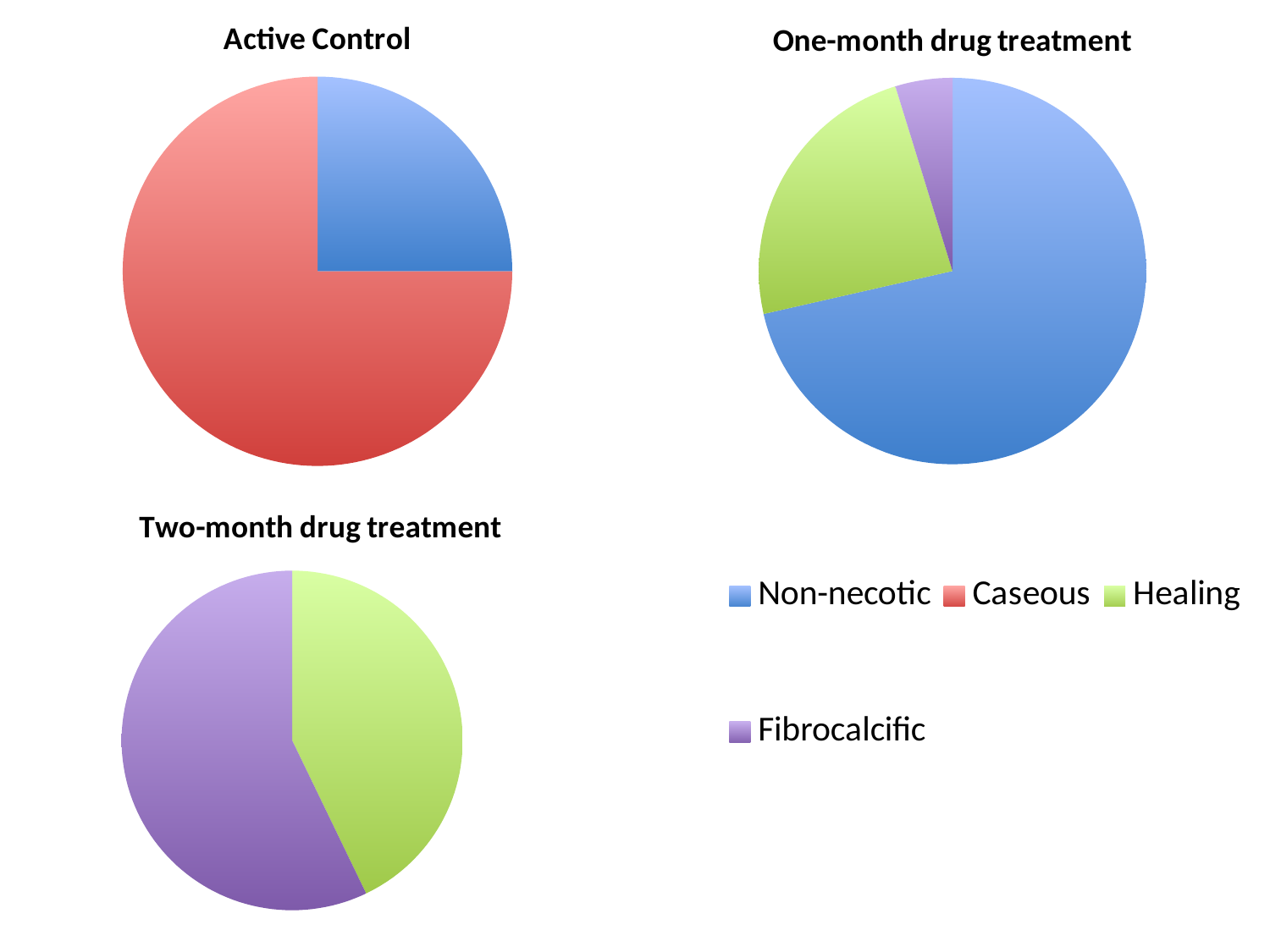
How many categories does the legend list? 4 In the "One-month drug treatment" chart, which category has the largest slice? Non-necotic In the "One-month drug treatment" chart, which slice is larger, Healing or Fibrocalcific? Healing In the "Active Control" chart, which category has the smallest slice? Non-necotic In the "One-month drug treatment" chart, which category has the smallest slice? Fibrocalcific Which chart on the slide contains a Caseous slice? Active Control How many slices does the "Two-month drug treatment" pie chart have? 2 In the "Two-month drug treatment" chart, which slice is larger, Fibrocalcific or Healing? Fibrocalcific In the "Active Control" chart, which category has the largest slice? Caseous How many slices does the "One-month drug treatment" pie chart have? 3 How many slices does the "Active Control" pie chart have? 2 What kind of chart is the "Active Control" chart? Pie chart